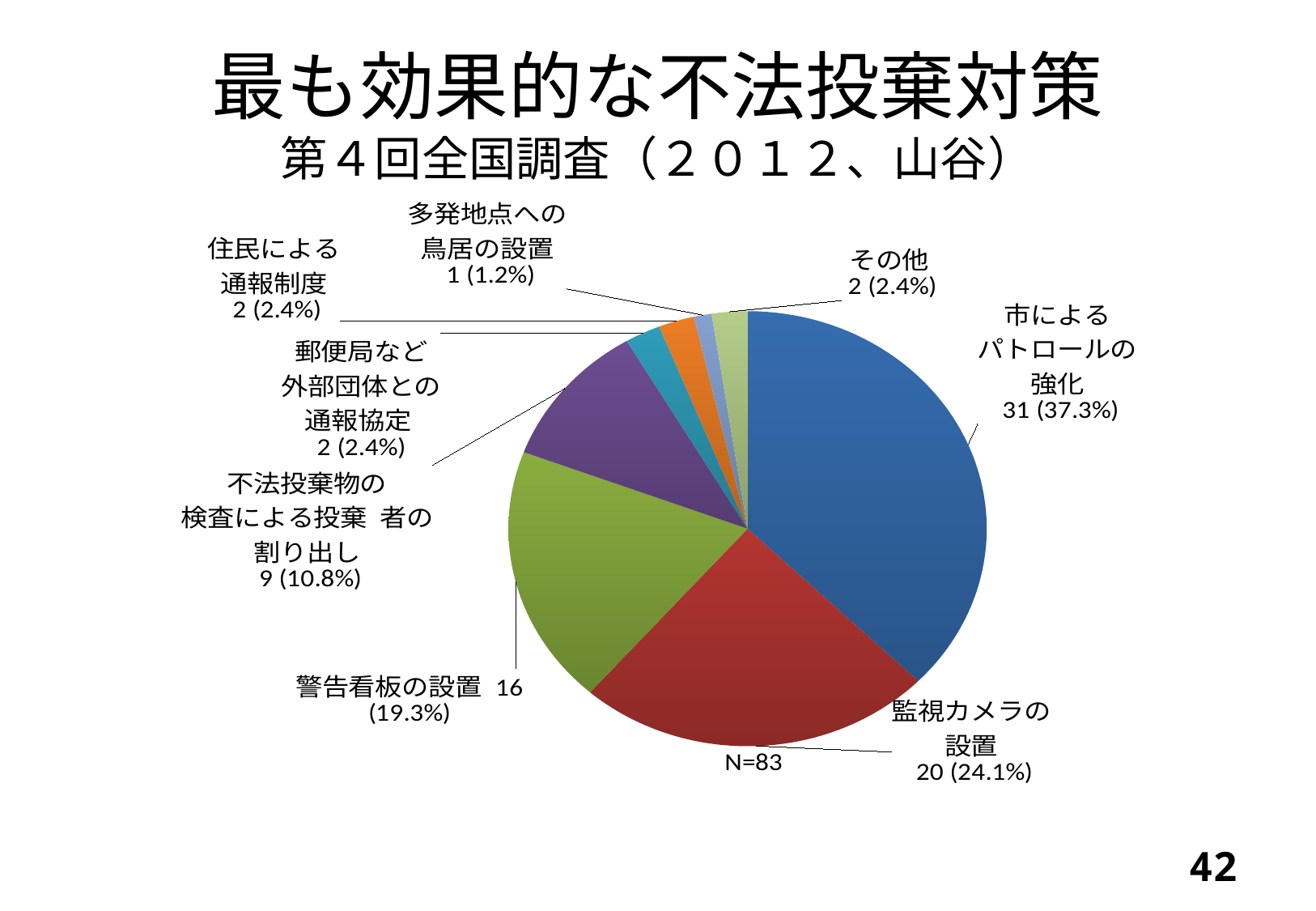
How many slices does the pie chart have? 8 What is the total number of responses (N) shown on the chart? N=83 What is the value shown for 市によるパトロールの強化? 31 (37.3%) What is the value shown for 監視カメラの設置? 20 (24.1%) What share of the pie does 多発地点への鳥居の設置 represent? 1.2% Which is larger, 警告看板の設置 or 監視カメラの設置? 監視カメラの設置 What is the difference in count between 市によるパトロールの強化 and 監視カメラの設置? 11 Which category has the largest slice of the pie? 市によるパトロールの強化 What is the value shown for 不法投棄物の検査による投棄者の割り出し? 9 (10.8%) What kind of chart is shown on the slide? pie chart Which category has the smallest slice of the pie? 多発地点への鳥居の設置 What is the value shown for 警告看板の設置? 16 (19.3%)